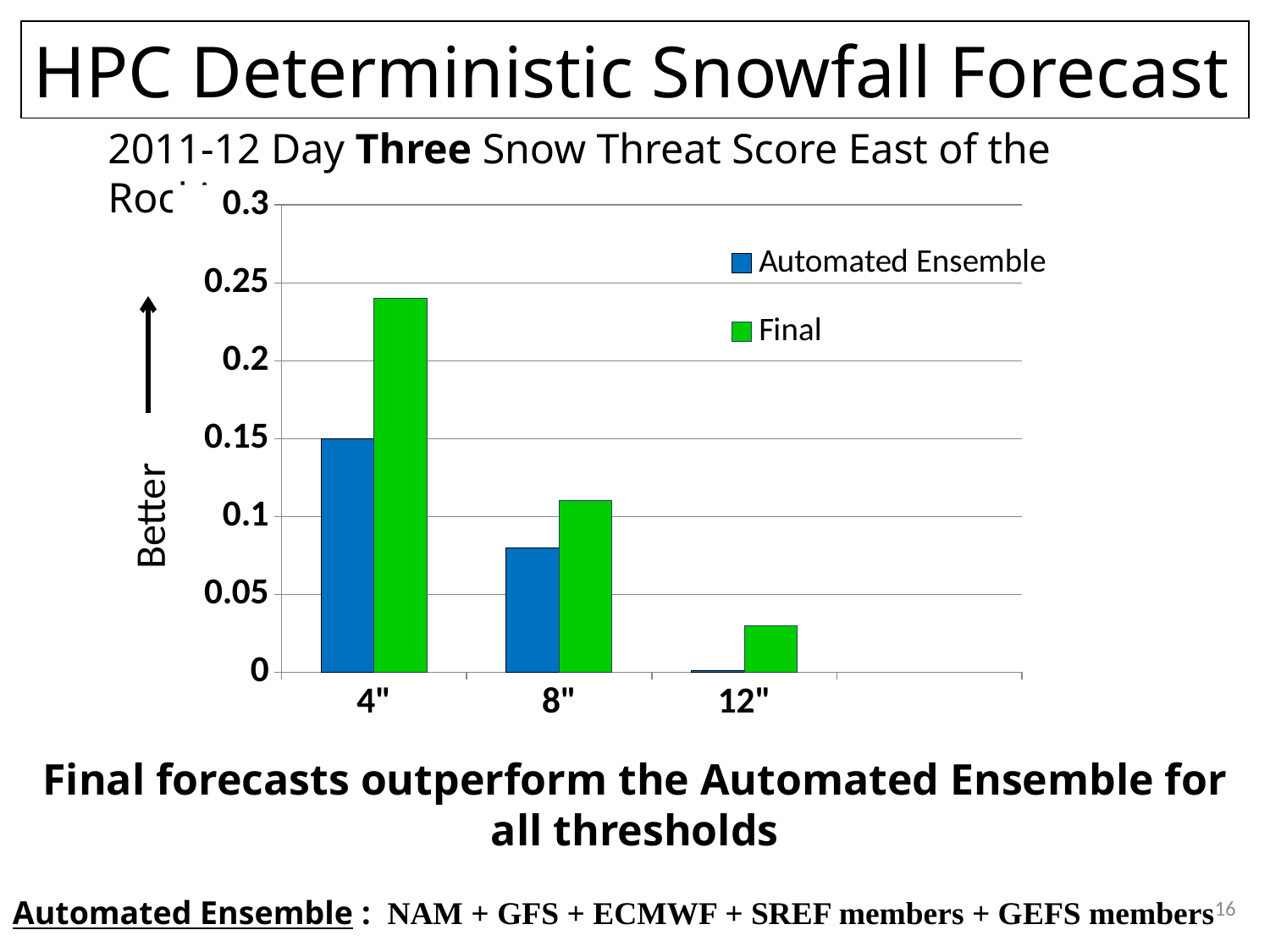
Is the value for Final at 12" greater or less than 0.05? less Is the value for Final at 4" greater or less than 0.2? greater How many series does the chart legend list? 2 For the Final series, which threshold has the highest threat score? 4" How many snowfall threshold categories are shown on the x axis? 3 Is the value for Automated Ensemble at 8" greater or less than 0.1? less What kind of chart is shown on the slide? bar chart What colour are the bars for the Final series? green Do the Final series values rise or fall as the threshold increases from 4" to 12"? fall Which series has the higher value at the 12" threshold, Automated Ensemble or Final? Final Which series has the higher value at the 4" threshold, Automated Ensemble or Final? Final For the Automated Ensemble series, which threshold has the lowest threat score? 12"